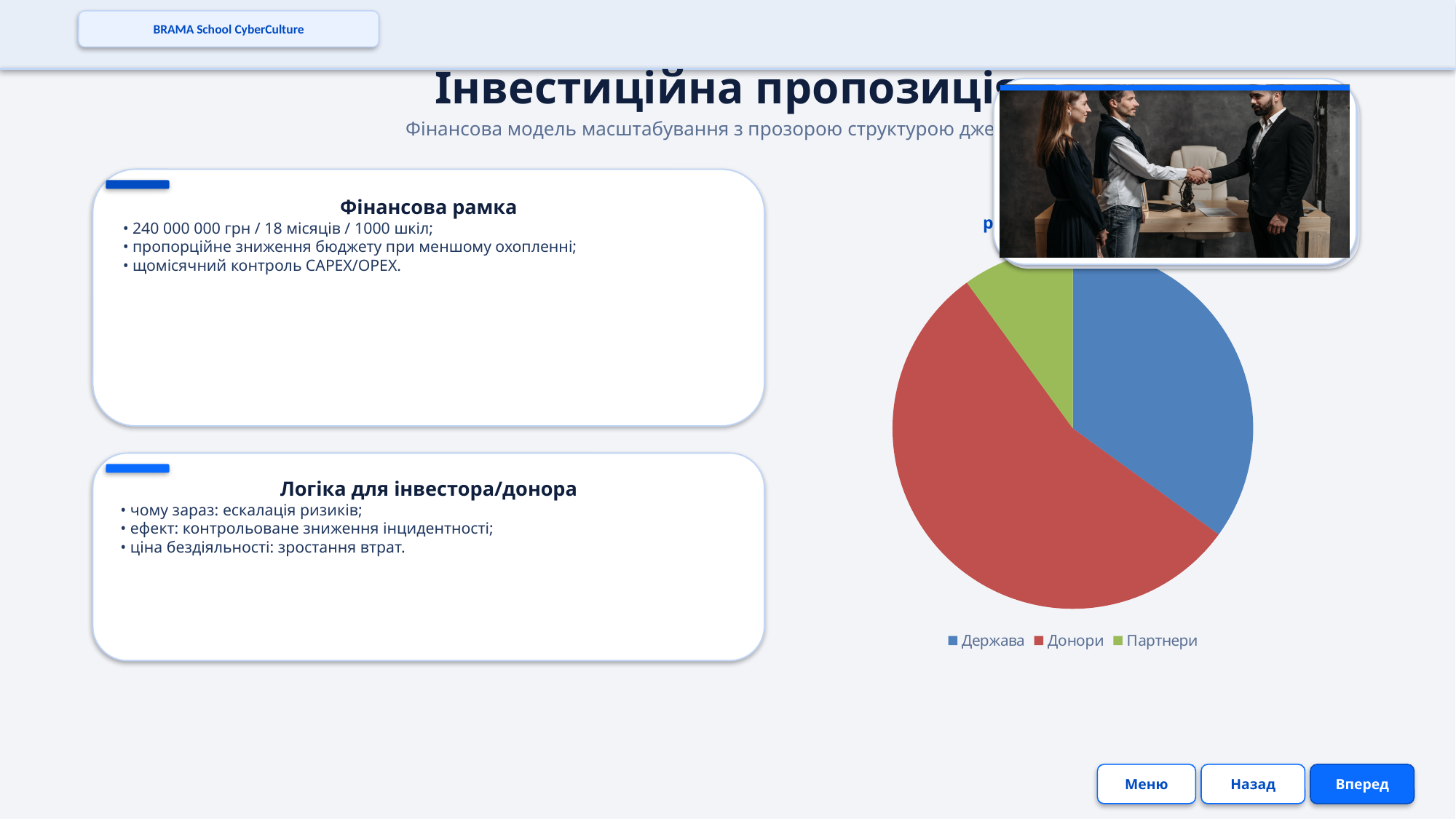
Which slice is smaller in the pie chart, Донори or Партнери? Партнери How many entries does the legend of the pie chart list? 3 Which slice is larger in the pie chart, Донори or Держава? Донори Which slice is larger in the pie chart, Держава or Партнери? Держава Which category has the largest slice in the pie chart? Донори What colour is the Держава slice in the pie chart? blue How many slices does the pie chart have? 3 What kind of chart is shown on the slide? pie chart Which category is shown in green in the pie chart? Партнери Which category has the smallest slice in the pie chart? Партнери